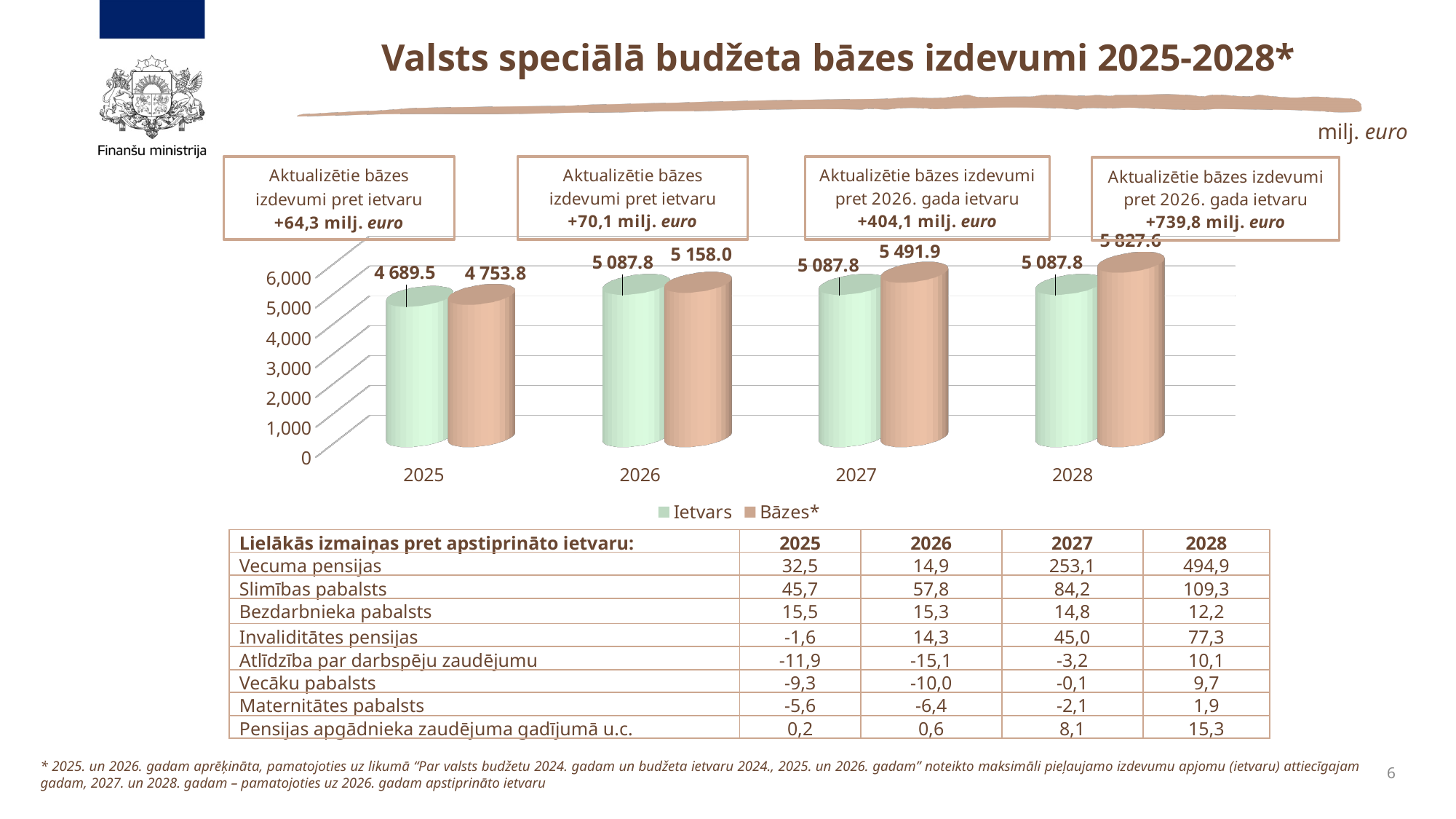
What is the difference between the Bāzes* and Ietvars values for 2027? 404.1 How many years are shown on the x axis of the chart? 4 How many series does the chart legend list? 2 What is the value of the Ietvars series for 2028? 5 087.8 What is the value of the Bāzes* series for 2026? 5 158.0 What is the difference between the Bāzes* and Ietvars values for 2025? 64.3 In which year is the Bāzes* series highest? 2028 Does the Bāzes* series rise or fall from 2025 to 2028? rise What is the value of the Bāzes* series for 2027? 5 491.9 In which year is the Ietvars series lowest? 2025 Which is larger in 2028, the Ietvars value or the Bāzes* value? Bāzes* What is the value of the Ietvars series for 2025? 4 689.5